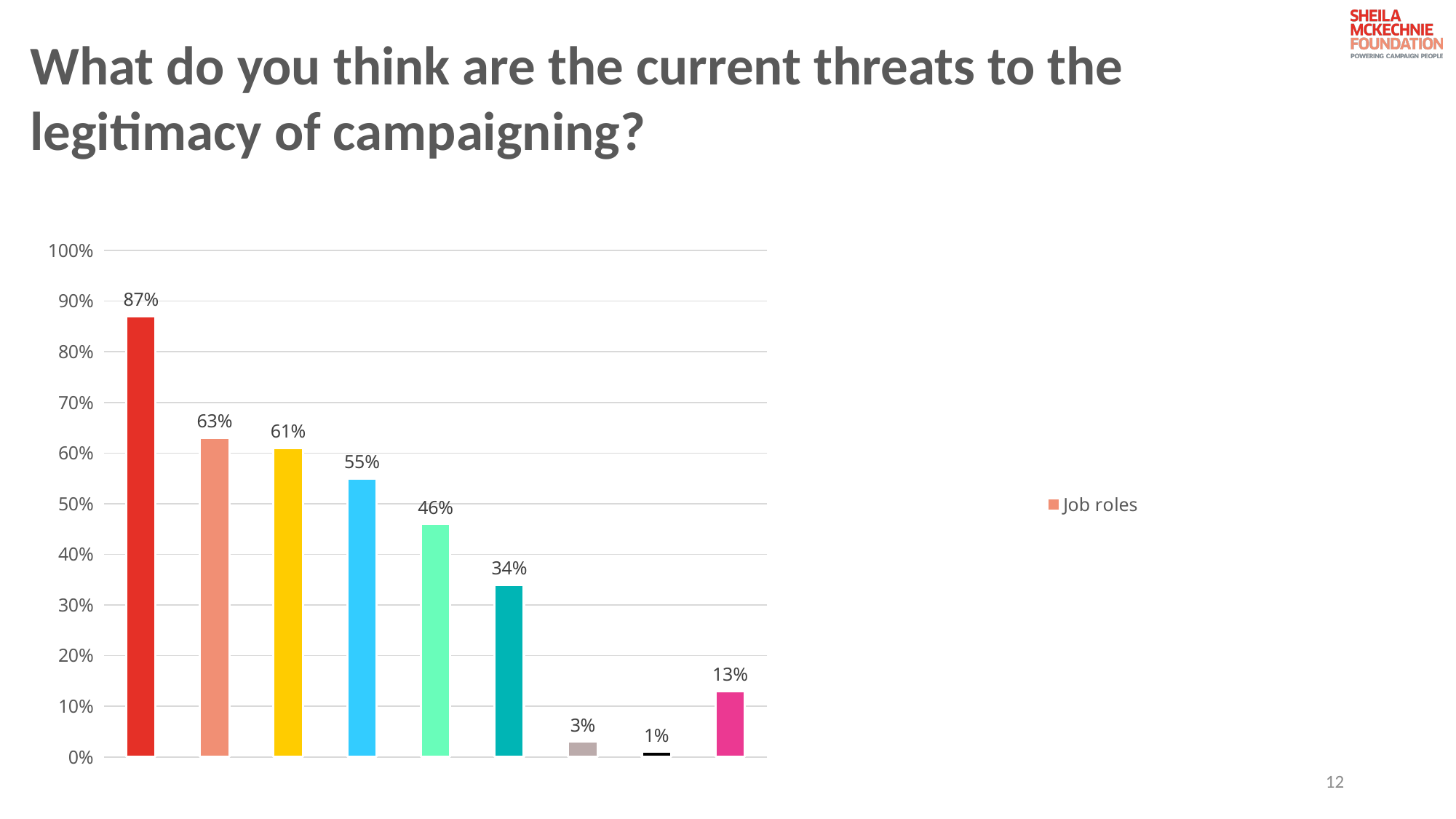
What is the value of the shortest bar in the chart? 1% What is the value of the last (pink) bar on the right? 13% What is the value of the tallest bar in the chart? 87% What is the legend entry shown next to the chart? Job roles What is the value of the fourth bar from the left (light blue)? 55% Is the value of the sixth bar from the left (teal) greater or less than 40%? less How many bars are plotted in the chart? 9 How many series does the legend list? 1 Which is larger, the second bar from the left or the third bar from the left? the second bar (63%) What type of chart is shown on the slide? bar chart What is the difference between the first bar (87%) and the second bar (63%)? 24% What is the value of the first (red) bar from the left? 87%